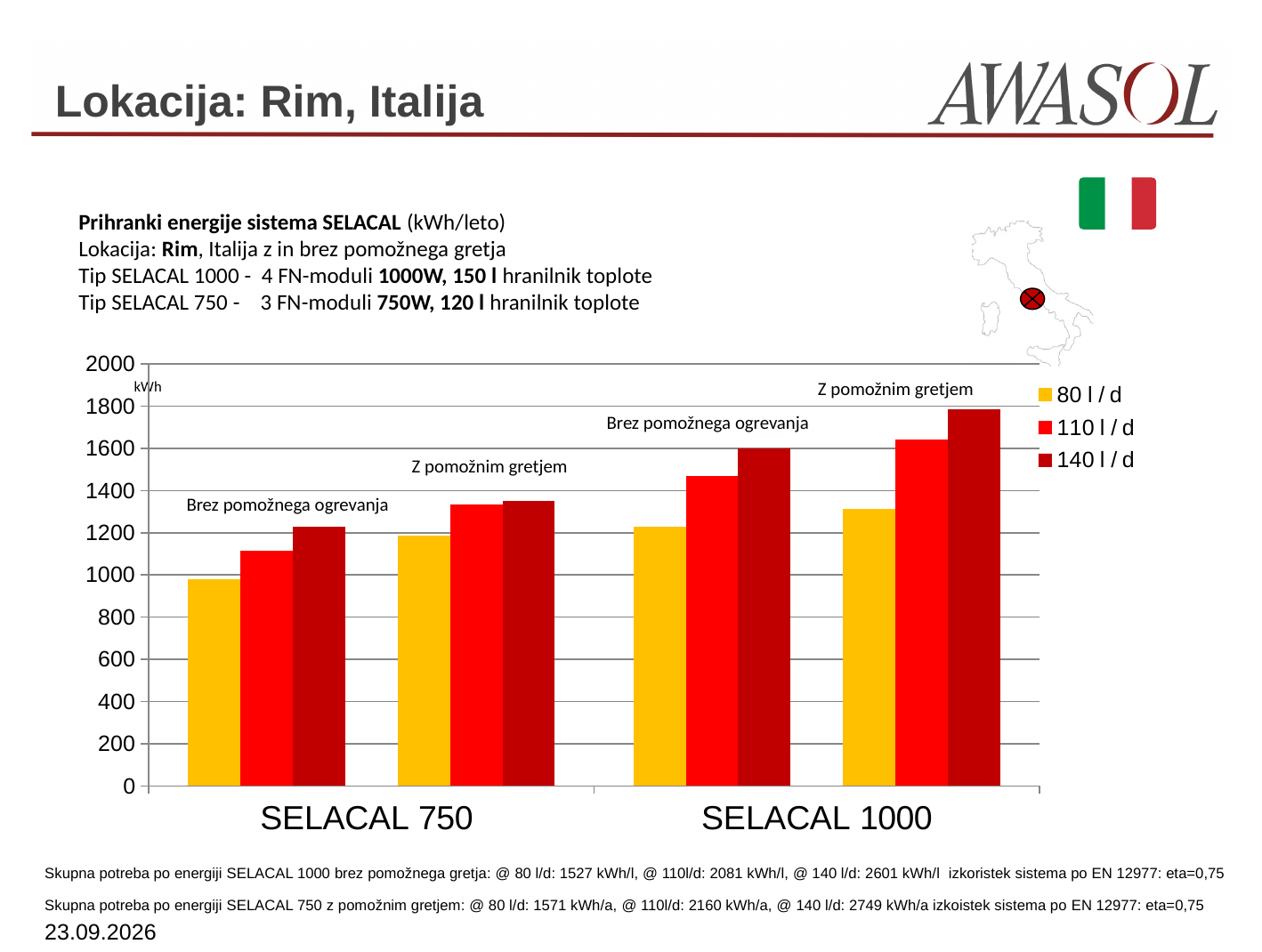
Which is larger: the 140 l / d value for SELACAL 750 'Z pomožnim gretjem' or the 140 l / d value for SELACAL 1000 'Brez pomožnega ogrevanja'? SELACAL 1000 'Brez pomožnega ogrevanja' Which series is shown in yellow in the chart legend? 80 l / d Do the 110 l / d values rise or fall moving from the SELACAL 750 groups to the SELACAL 1000 groups? rise Is the value for 110 l / d in the SELACAL 1000 'Brez pomožnega ogrevanja' group greater or less than 1400? greater How many series does the chart legend list? 3 Which series has the tallest bar in every group of the chart? 140 l / d Which bar is the lowest in the whole chart? 80 l / d, SELACAL 750 without auxiliary heating (Brez pomožnega ogrevanja) What kind of chart is shown on the slide? bar chart What unit is written at the top of the vertical axis of the chart? kWh Is the value for 140 l / d in the SELACAL 1000 'Z pomožnim gretjem' group greater or less than 1600? greater